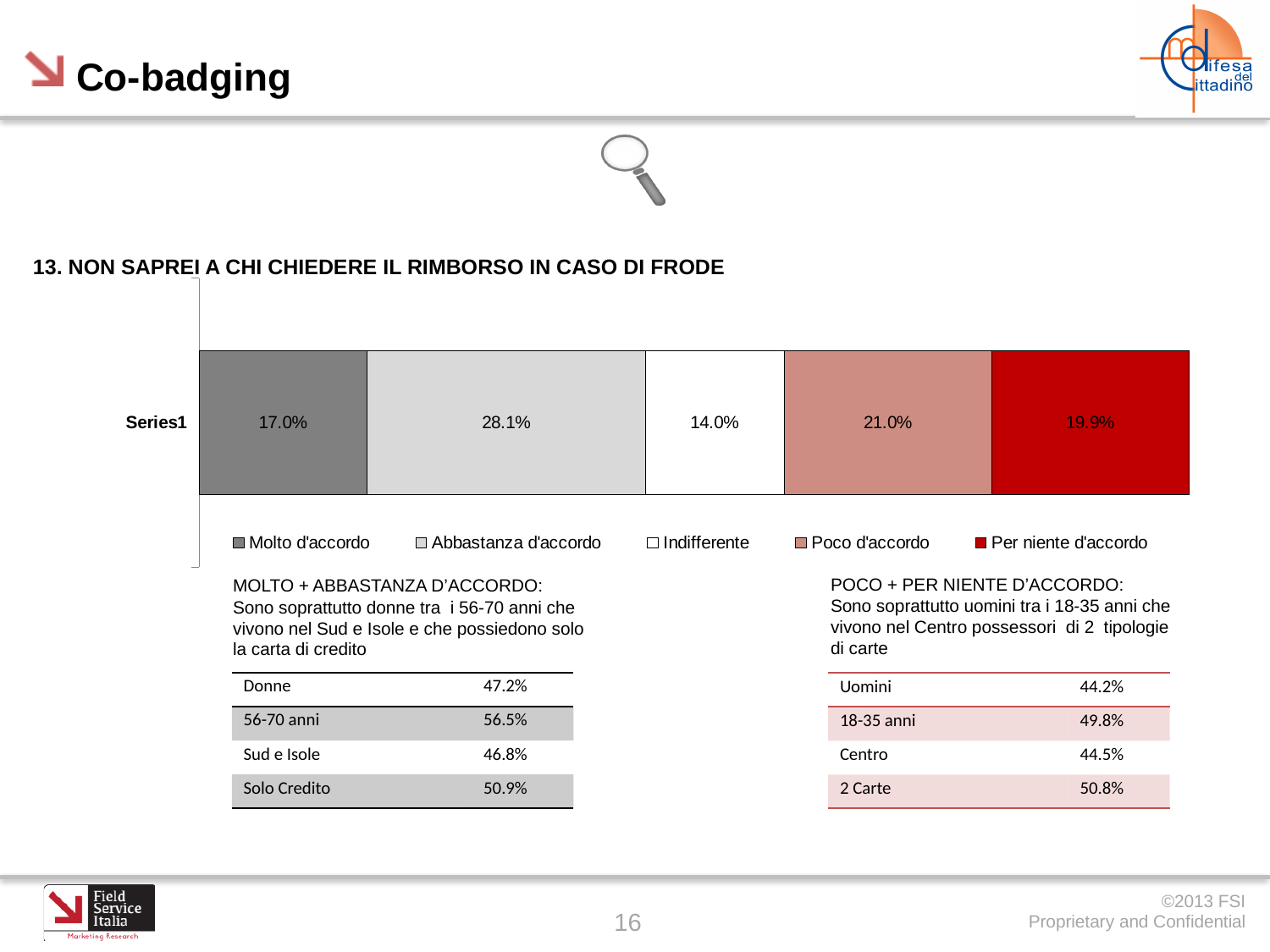
What is the value for Molto d'accordo in the stacked bar? 17.0% What is the value for Indifferente in the stacked bar? 14.0% What colour is the Per niente d'accordo segment in the stacked bar? Red Which series has the smallest segment in the stacked bar? Indifferente What is the difference between the Abbastanza d'accordo and Molto d'accordo values? 11.1% What is the total of the Molto d'accordo and Abbastanza d'accordo segments? 45.1% What kind of chart is shown on the slide? Stacked bar chart What is the value for Per niente d'accordo in the stacked bar? 19.9% Which series has the largest segment in the stacked bar? Abbastanza d'accordo Which is larger, Poco d'accordo or Per niente d'accordo? Poco d'accordo How many series does the legend list? 5 What is the value for Abbastanza d'accordo in the stacked bar? 28.1%